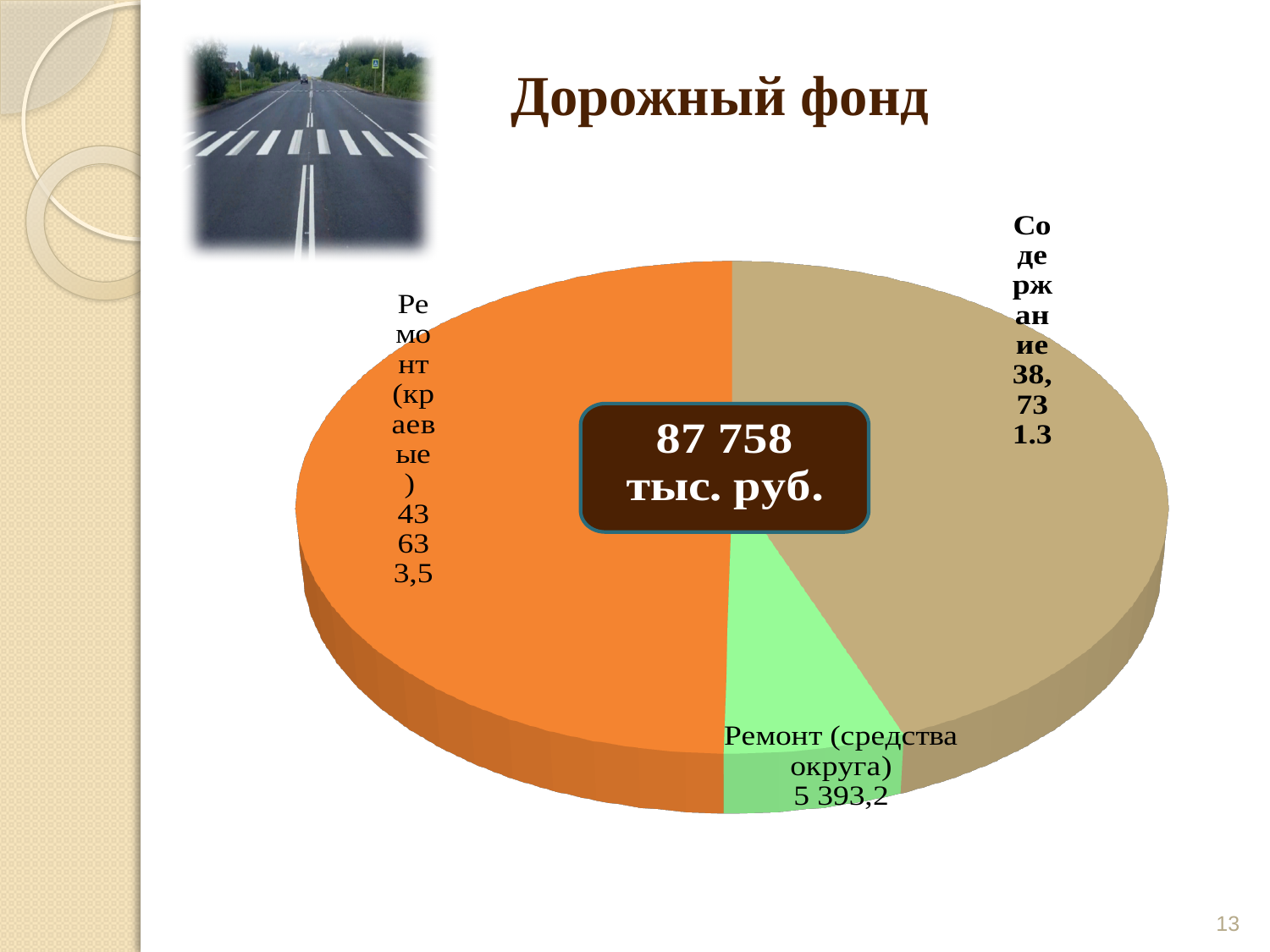
What is the difference between Ремонт (краевые) and Ремонт (средства округа)? 38 240,3 What is the value for Ремонт (краевые)? 43 633,5 What total amount is shown in the centre of the pie chart? 87 758 тыс. руб. Which slice of the pie chart is the largest? Ремонт (краевые) How many slices does the pie chart have? 3 Which slice of the pie chart is the smallest? Ремонт (средства округа) What is the title of the chart on the slide? Дорожный фонд What colour is the Ремонт (средства округа) slice? green What is the value for Ремонт (средства округа)? 5 393,2 Which is larger, Содержание or Ремонт (средства округа)? Содержание What kind of chart is shown on the slide? pie chart What is the value for Содержание? 38,731.3